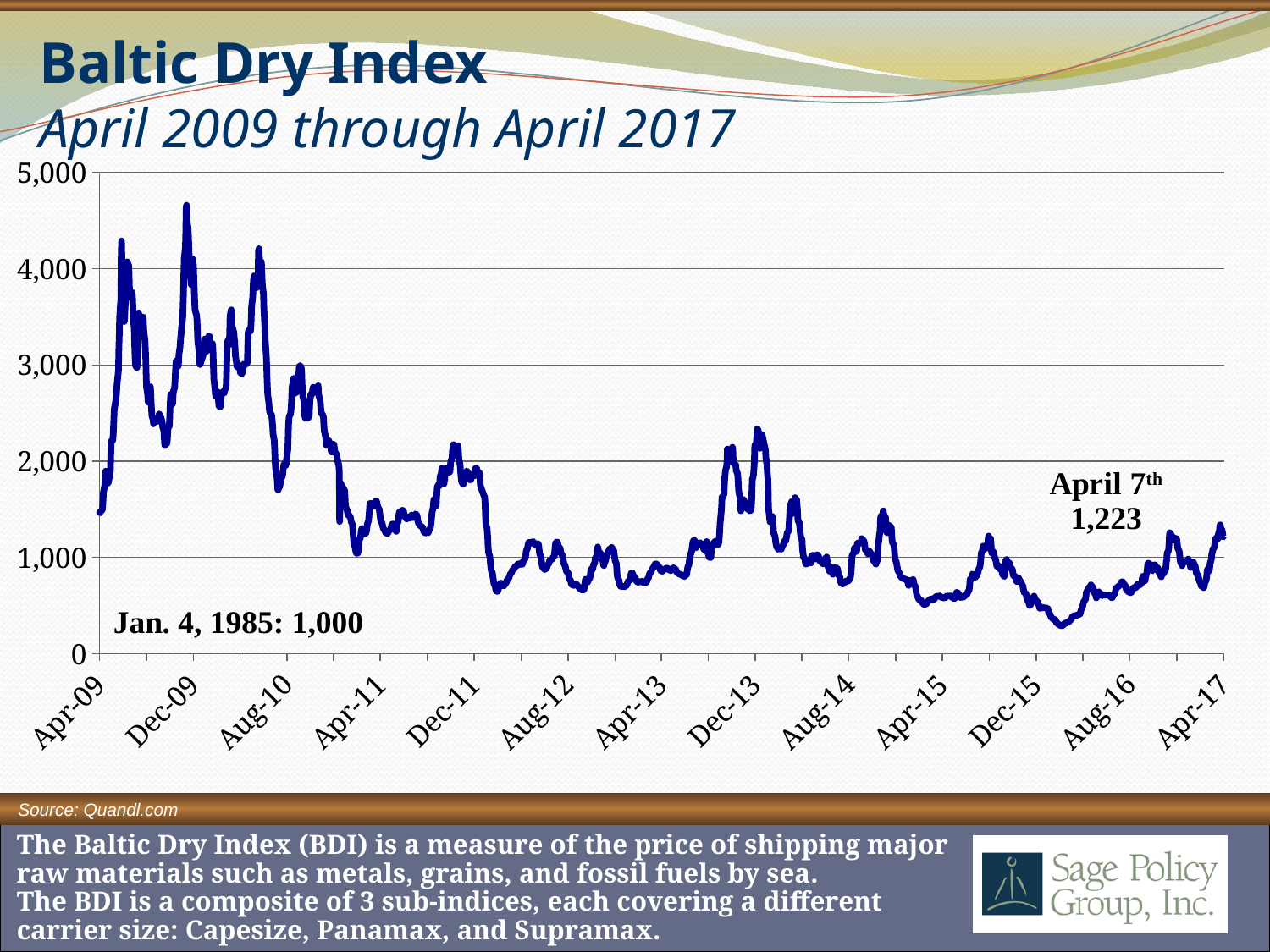
Is the peak near Dec-13 greater or less than 3,000? less Is the lowest point of the series, in early 2016, greater or less than 1,000? less What is the highest value shown on the y axis? 5,000 Is the highest peak of the series, near Dec-09, greater or less than 4,000? greater What source is cited for the chart? Quandl.com What kind of chart is shown on the slide? line chart What value does the chart label for April 7th? 1,223 How many date labels are shown on the x axis? 13 What value does the chart give for Jan. 4, 1985? 1,000 Near which x-axis label does the series reach its highest value? Dec-09 Overall, does the Baltic Dry Index rise or fall from Apr-09 to Apr-17? fall